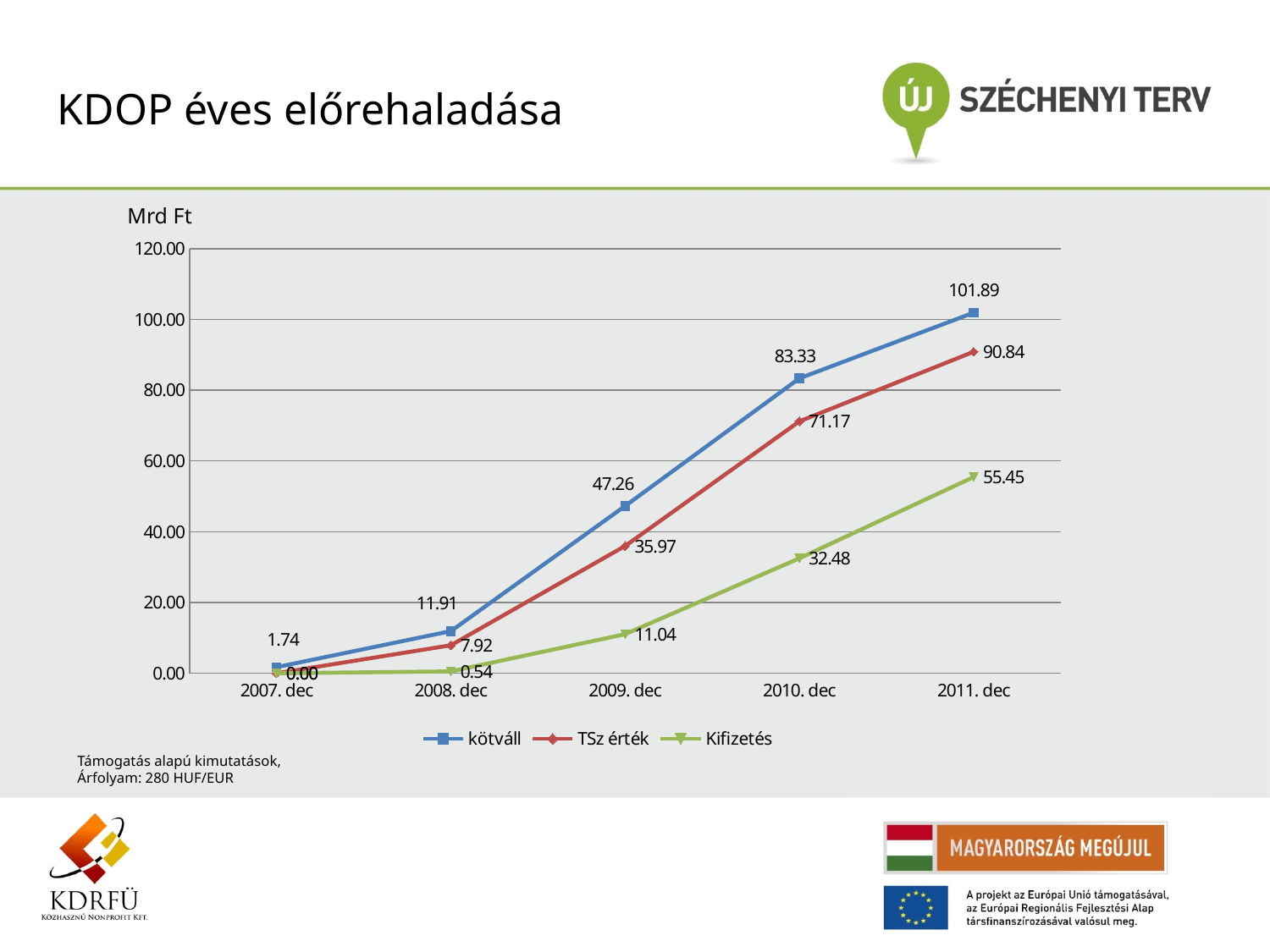
In which year does the kötváll series reach its highest value? 2011. dec What kind of chart is shown on the slide? line chart How many series does the legend list? 3 What is the value for kötváll in 2011. dec? 101.89 In which year is the Kifizetés series lowest? 2007. dec How many time points are shown on the x axis? 5 What is the value for Kifizetés in 2009. dec? 11.04 Does the TSz érték series rise or fall from 2007. dec to 2011. dec? rise What is the difference between kötváll and TSz érték in 2011. dec? 11.05 What is the value for Kifizetés in 2008. dec? 0.54 What is the value for TSz érték in 2010. dec? 71.17 Which is larger in 2010. dec, kötváll or Kifizetés? kötváll